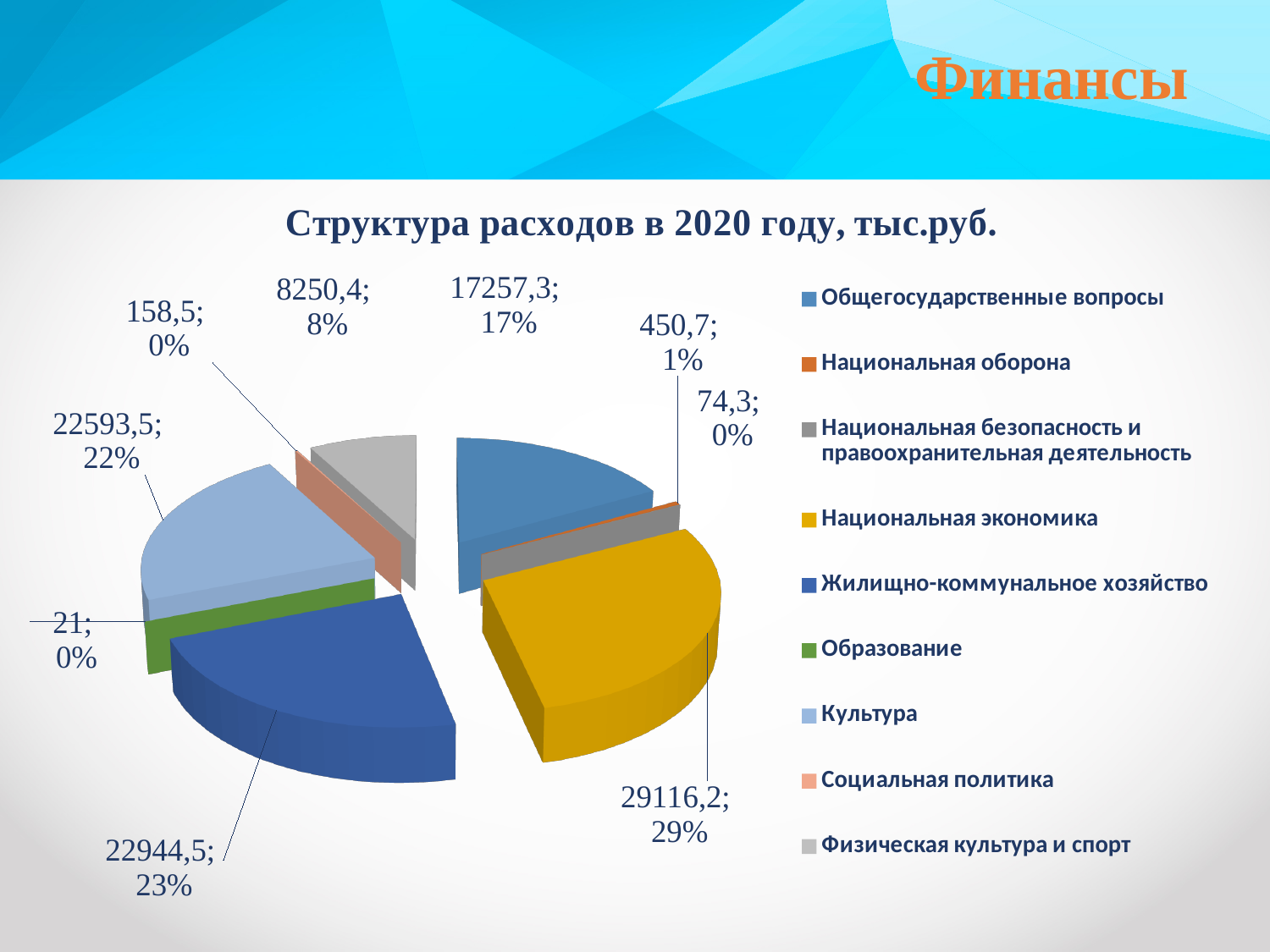
Which is larger, Жилищно-коммунальное хозяйство or Культура? Жилищно-коммунальное хозяйство Which category has the largest slice of the pie? Национальная экономика What is the title of the chart? Структура расходов в 2020 году, тыс.руб. What kind of chart is shown on the slide? pie chart What share of the pie does Культура take? 22% What is the difference between the values for Национальная экономика and Жилищно-коммунальное хозяйство? 6171,7 How many categories does the legend list? 9 What is the value for Жилищно-коммунальное хозяйство? 22944,5 What is the value for Физическая культура и спорт? 8250,4 What share of the pie does Национальная экономика take? 29% Which category has the smallest slice of the pie? Образование What is the value for Национальная экономика? 29116,2